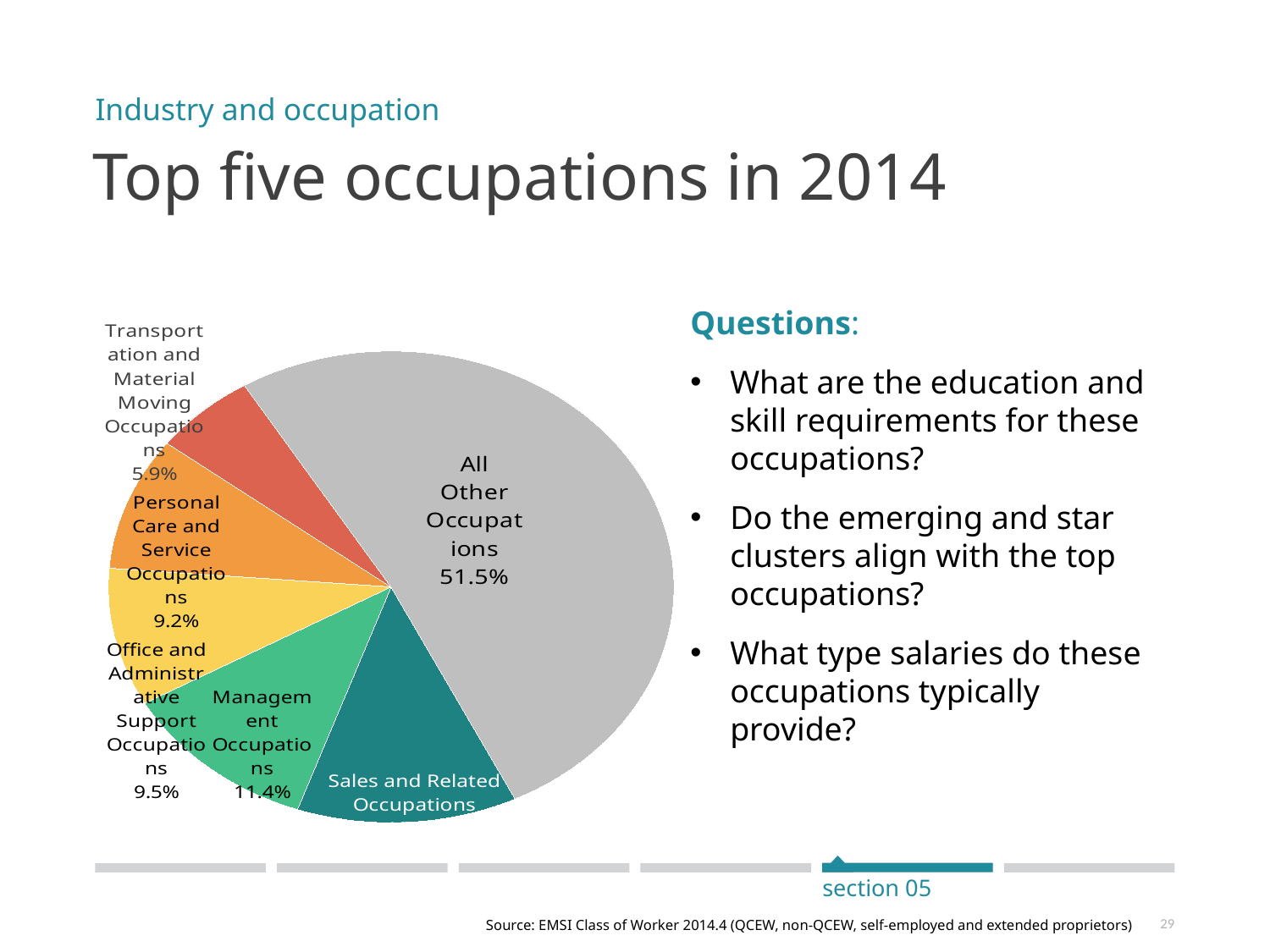
How many slices does the pie chart have? 6 What percentage is shown for Management Occupations? 11.4% Which slice of the pie is the largest? All Other Occupations What percentage is shown for Office and Administrative Support Occupations? 9.5% Which is larger: Personal Care and Service Occupations or Transportation and Material Moving Occupations? Personal Care and Service Occupations What percentage is shown for Transportation and Material Moving Occupations? 5.9% What percentage is shown for Personal Care and Service Occupations? 9.2% What is the title of the chart on the slide? Top five occupations in 2014 What type of chart is shown on the slide? Pie chart What is the difference in percentage points between Management Occupations and Office and Administrative Support Occupations? 1.9 What share of the pie is All Other Occupations? 51.5% Which labelled occupation group has the smallest share of the pie? Transportation and Material Moving Occupations